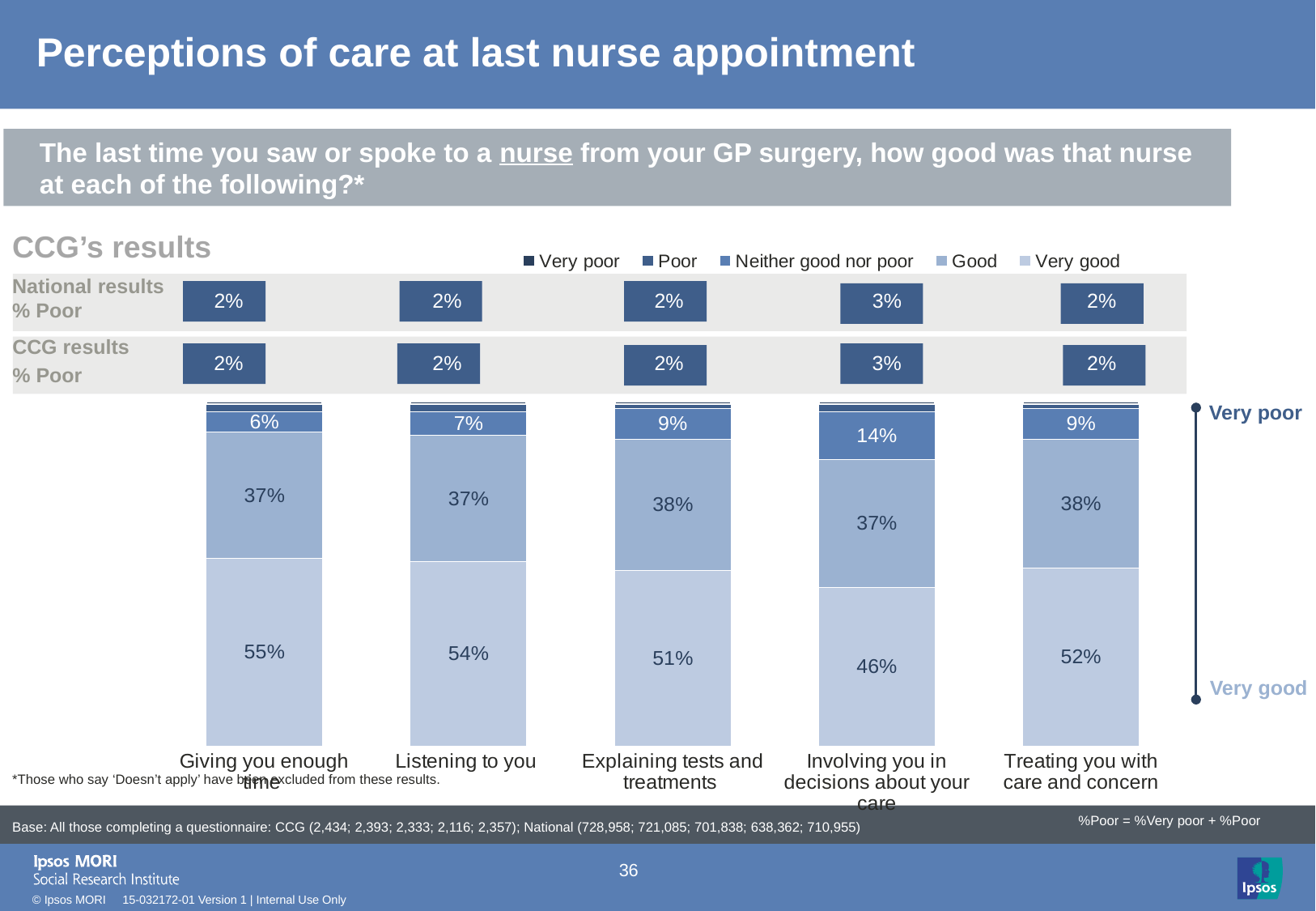
What kind of chart is shown on the slide? Stacked bar chart What is the 'Good' value for 'Involving you in decisions about your care'? 37% Which category has the highest 'Very good' value? Giving you enough time How many categories (aspects of care) are plotted along the x axis? 5 Which has the larger 'Neither good nor poor' value: 'Involving you in decisions about your care' or 'Listening to you'? Involving you in decisions about your care How many series does the chart legend list? 5 Which category has the lowest 'Very good' value? Involving you in decisions about your care What is the 'Very good' value for 'Giving you enough time'? 55% What is the CCG results '% Poor' value for 'Involving you in decisions about your care'? 3% What is the difference between the 'Very good' values for 'Giving you enough time' and 'Involving you in decisions about your care'? 9 percentage points What is the first entry in the chart legend? Very poor What is the 'Neither good nor poor' value for 'Explaining tests and treatments'? 9%